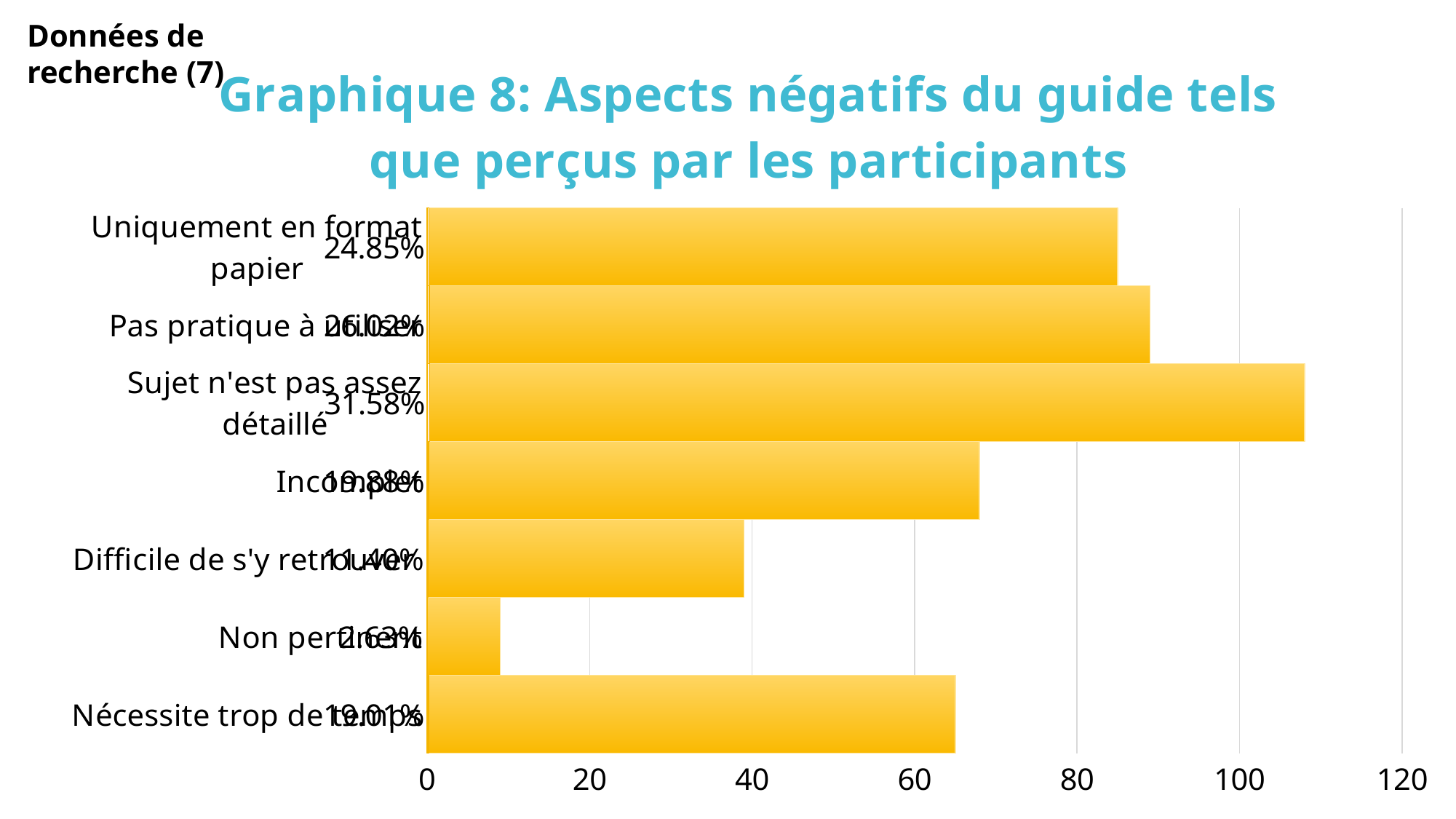
How many categories are plotted in the chart? 7 What percentage label is shown for 'Difficile de s'y retrouver'? 11.40% What percentage label is shown for 'Sujet n'est pas assez détaillé'? 31.58% Which category has the longest bar? Sujet n'est pas assez détaillé What kind of chart is shown on the slide? bar chart What is the title of the chart? Graphique 8: Aspects négatifs du guide tels que perçus par les participants Which bar is longer, 'Incomplet' or 'Difficile de s'y retrouver'? Incomplet What percentage label is shown for 'Uniquement en format papier'? 24.85% Is the bar for 'Sujet n'est pas assez détaillé' greater or less than 100 on the axis? greater What percentage label is shown for 'Non pertinent'? 2.63% Which category has the shortest bar? Non pertinent Is the bar for 'Non pertinent' greater or less than 20 on the axis? less